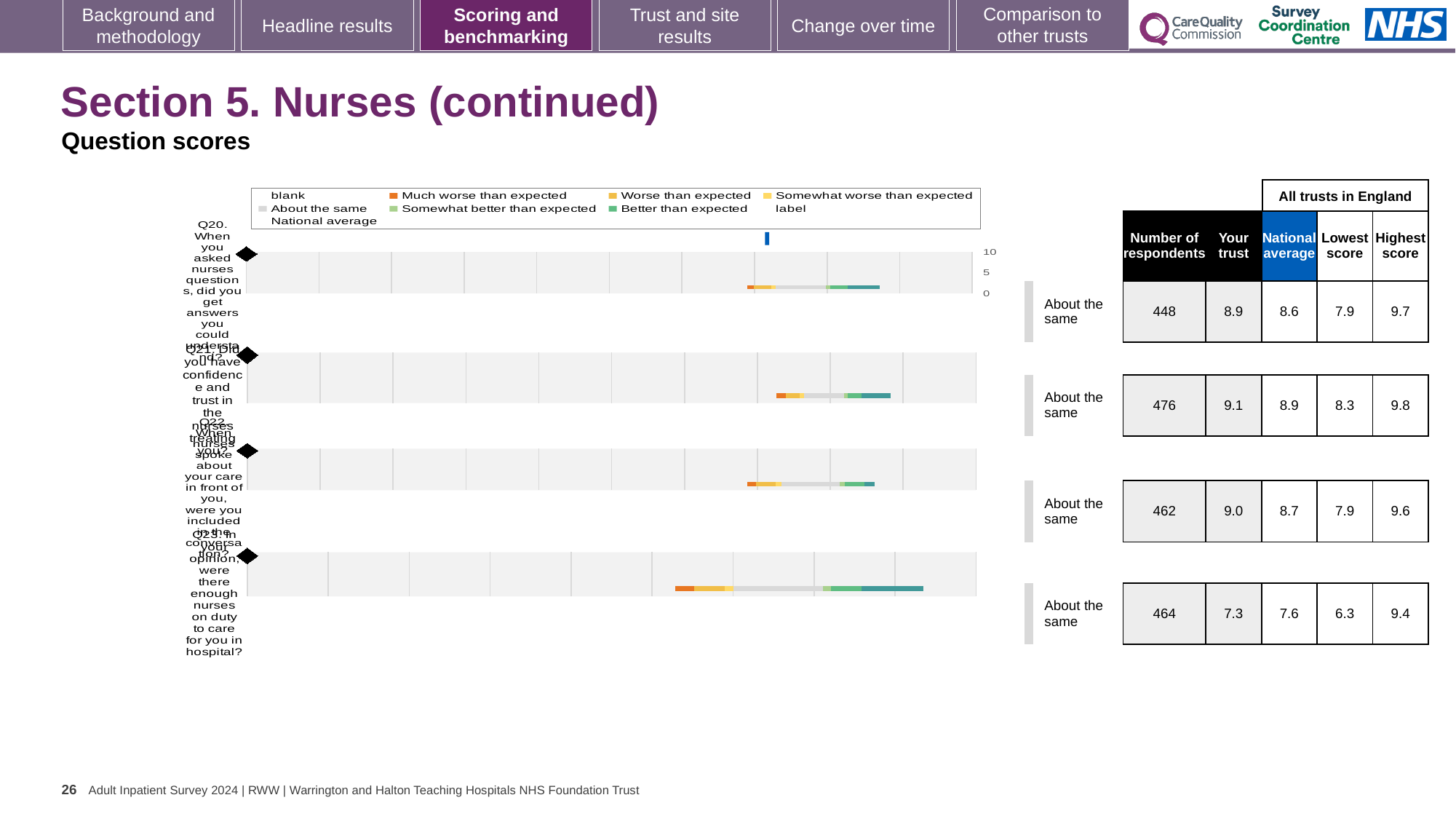
For Q23, which is larger: the 'Your trust' score or the national average? National average How many respondents are listed for Q22? 462 How many question charts (Q20 to Q23) are shown on the slide? 4 What kind of chart is used to show the Q20 question score? bar chart For Q21, what is the difference between the highest score and the lowest score in the table? 1.5 Which question has the highest 'Your trust' score in the table? Q21 In the table beside the Q20 chart, what is the 'Your trust' score? 8.9 Which legend entry is shown in grey? About the same For Q22, what is the difference between the 'Your trust' score and the national average? 0.3 What is the highest tick value shown on the axis of the Q20 chart? 10 In the table beside the Q23 chart, what is the national average score? 7.6 Which question has the lowest 'Your trust' score in the table? Q23